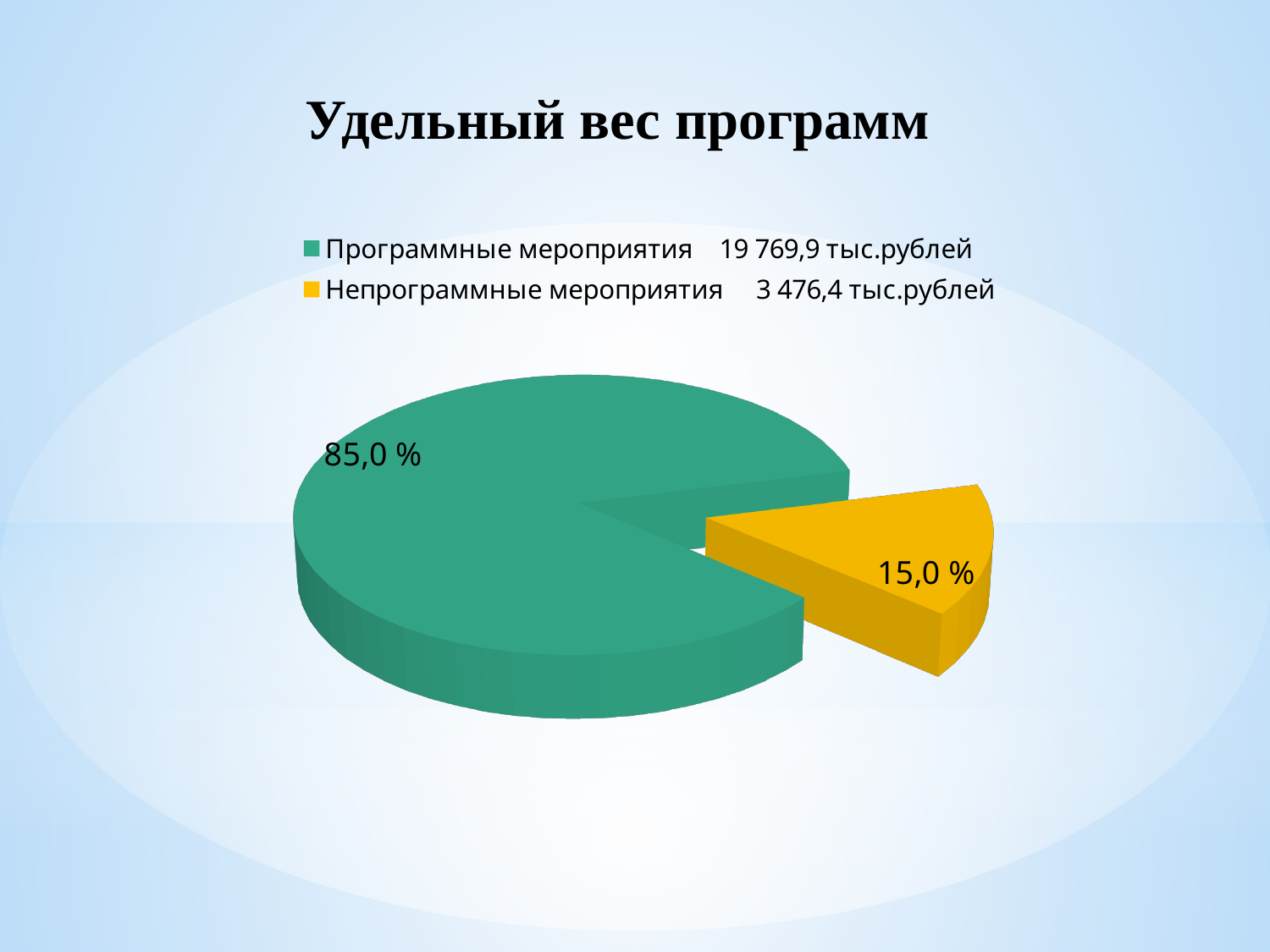
What is the difference in percentage points between the Программные мероприятия slice and the Непрограммные мероприятия slice? 70,0 percentage points According to the legend, what amount in тыс.рублей corresponds to Непрограммные мероприятия? 3 476,4 тыс.рублей Which is larger: the slice for Программные мероприятия or the slice for Непрограммные мероприятия? Программные мероприятия What is the title of the chart? Удельный вес программ Which category has the smallest slice of the pie? Непрограммные мероприятия According to the legend, what amount in тыс.рублей corresponds to Программные мероприятия? 19 769,9 тыс.рублей Which category has the largest slice of the pie? Программные мероприятия What share of the pie does Программные мероприятия take? 85,0 % How many slices does the pie chart have? 2 What share of the pie does Непрограммные мероприятия take? 15,0 % What colour is the slice for Непрограммные мероприятия? yellow What kind of chart is shown on the slide? pie chart